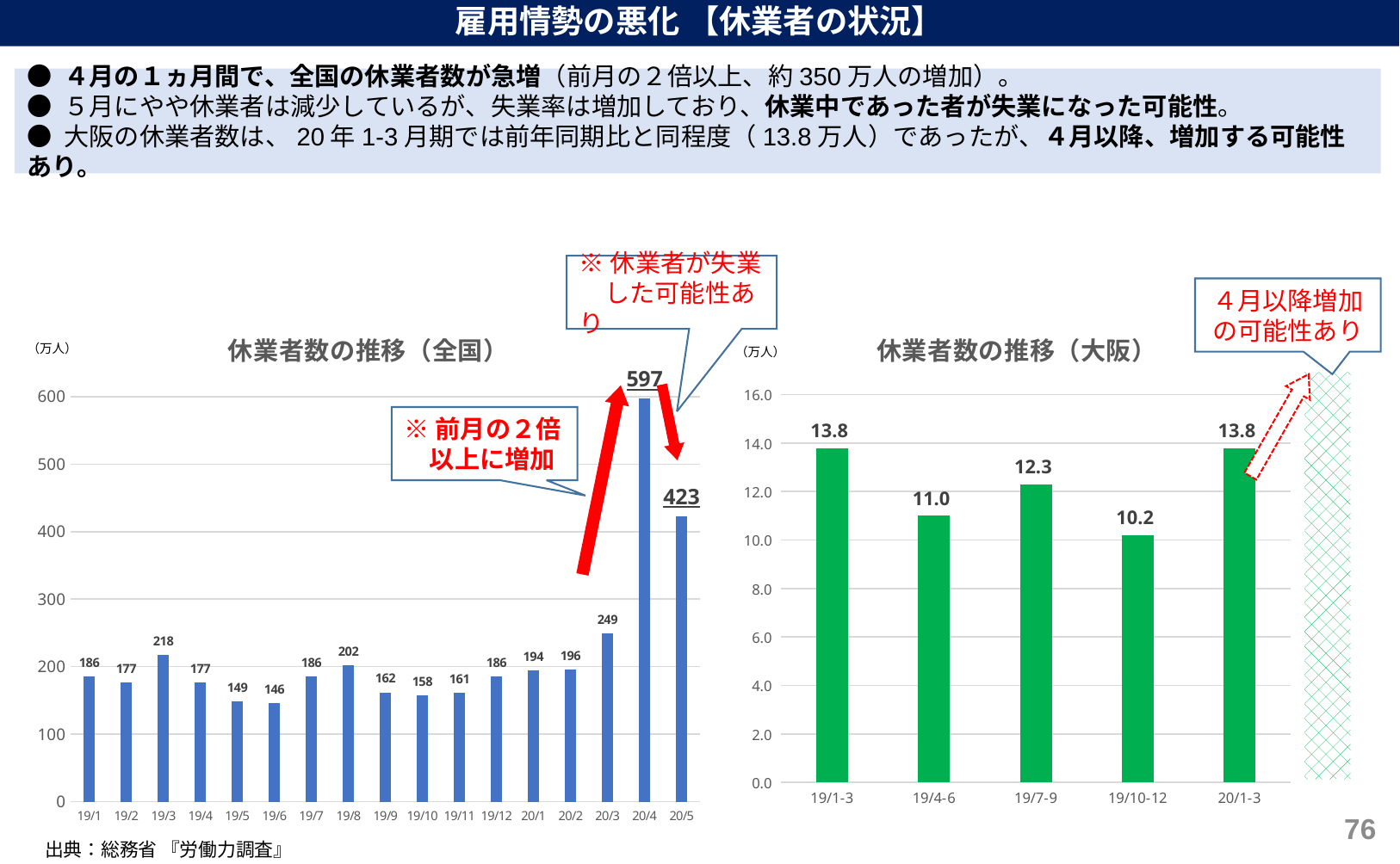
In the 休業者数の推移（大阪） chart, what is the value for 19/10-12? 10.2 What kind of chart is the 休業者数の推移（大阪） chart? bar chart In the 休業者数の推移（全国） chart, is the value for 20/3 greater or less than 200? greater In the 休業者数の推移（全国） chart, which month has the lowest value? 19/6 In the 休業者数の推移（全国） chart, what is the value for 20/4? 597 In the 休業者数の推移（大阪） chart, which quarter has the lowest value? 19/10-12 In the 休業者数の推移（全国） chart, how many months are plotted? 17 In the 休業者数の推移（大阪） chart, which is larger, the value for 19/4-6 or 19/7-9? 19/7-9 In the 休業者数の推移（全国） chart, what is the value for 19/3? 218 In the 休業者数の推移（全国） chart, what is the value for 20/5? 423 In the 休業者数の推移（全国） chart, which month has the highest value? 20/4 In the 休業者数の推移（全国） chart, what is the difference between the values for 20/4 and 20/3? 348